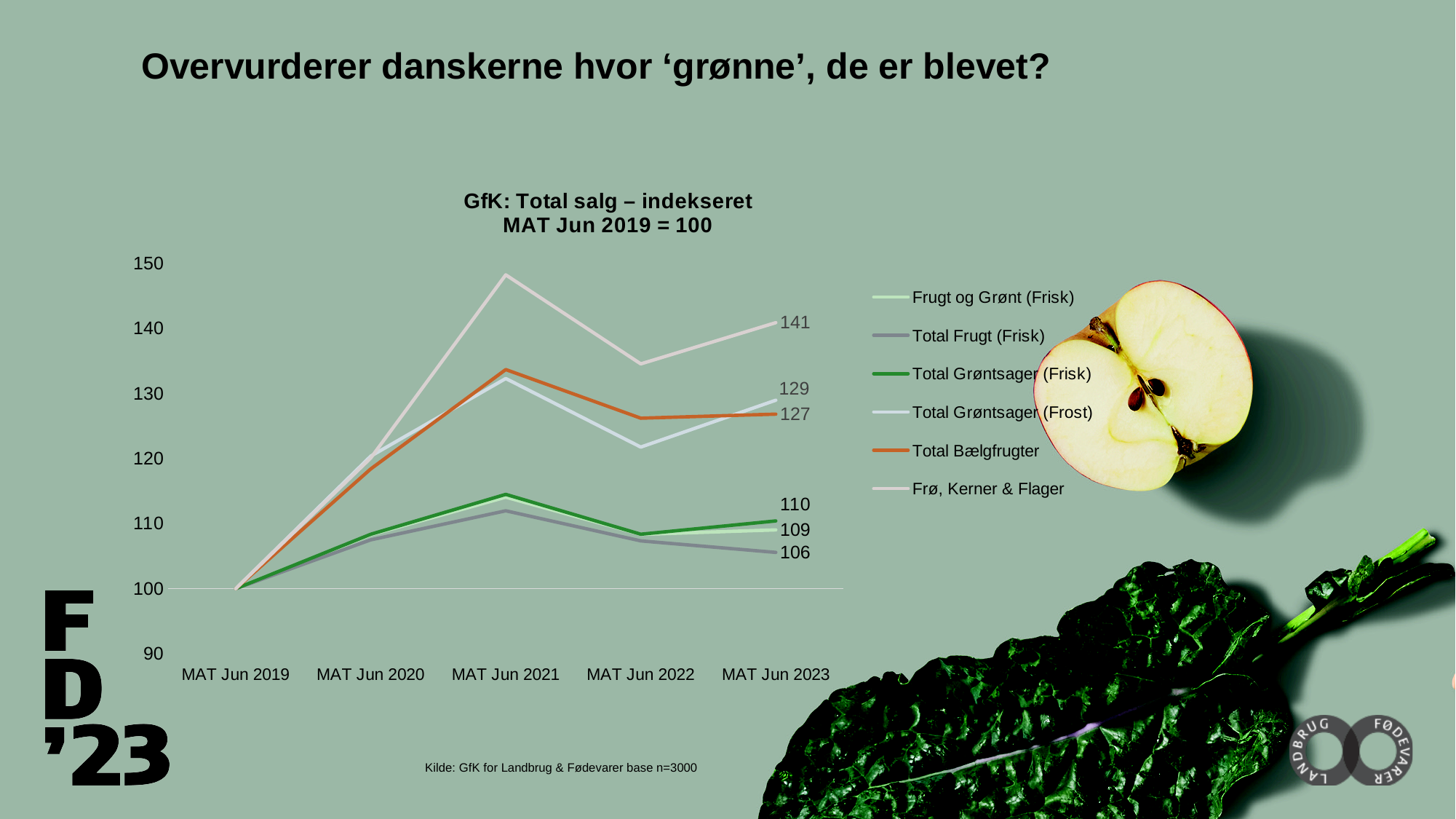
What is the value for Frø, Kerner & Flager at MAT Jun 2023? 141 Which series has the lowest value at MAT Jun 2023? Total Frugt (Frisk) What is the value for Total Frugt (Frisk) at MAT Jun 2023? 106 What is the title of the chart? GfK: Total salg – indekseret MAT Jun 2019 = 100 Is the value for Frø, Kerner & Flager at MAT Jun 2021 greater or less than 140? greater What is the value for Total Bælgfrugter at MAT Jun 2023? 127 At MAT Jun 2023, which is larger: Total Grøntsager (Frisk) or Total Frugt (Frisk)? Total Grøntsager (Frisk) What is the difference between Frø, Kerner & Flager and Total Grøntsager (Frost) at MAT Jun 2023? 12 Which series has the highest value at MAT Jun 2023? Frø, Kerner & Flager What kind of chart is shown on the slide? line chart How many series does the legend list? 6 How many time points are shown on the x axis? 5